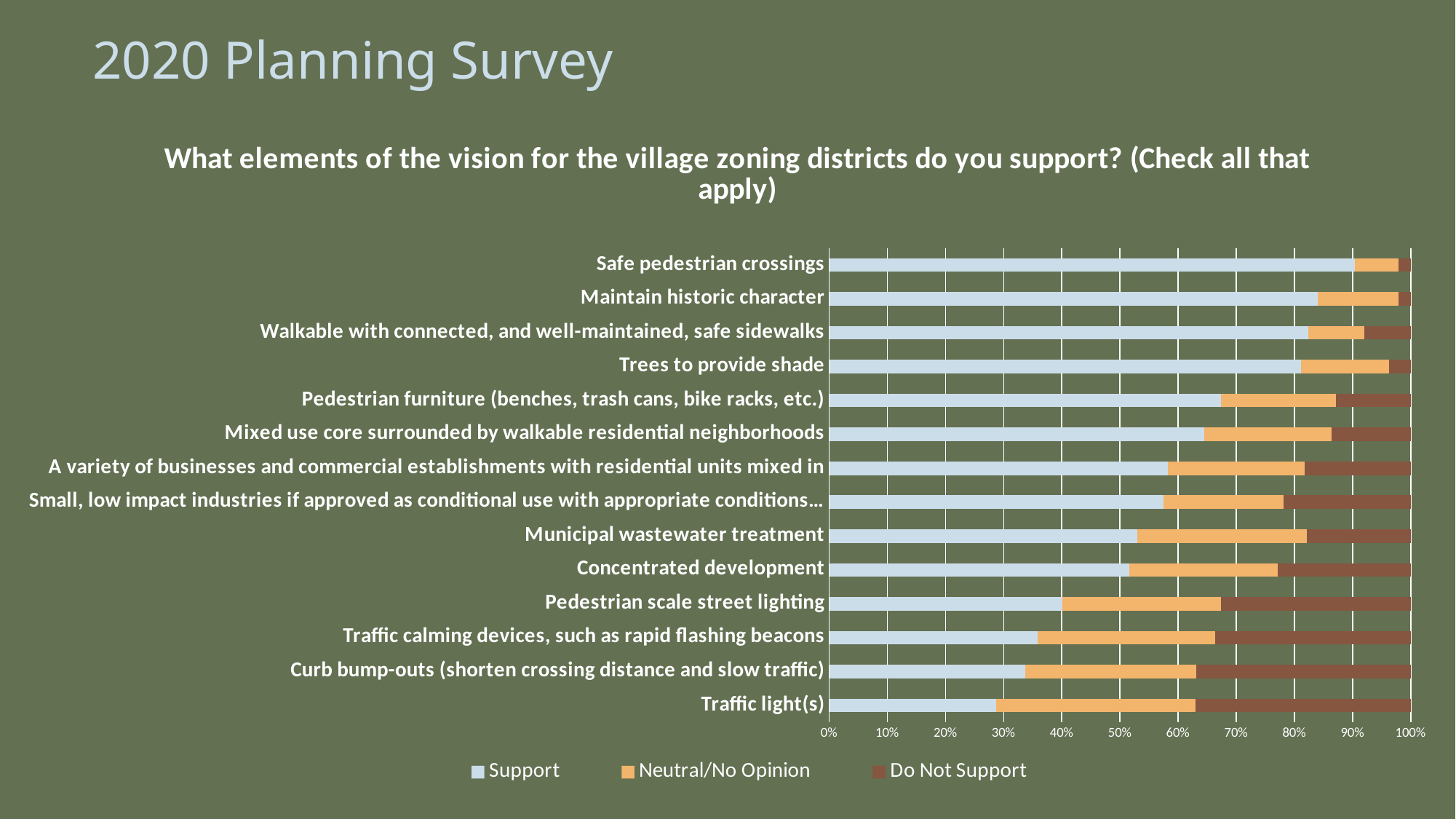
What does each stacked bar in the chart total on the x axis? 100% Which vision element has the highest Support share? Safe pedestrian crossings Which vision element has the lowest Support share? Traffic light(s) How many categories (vision elements) are plotted in the chart? 14 Is the Support value for Trees to provide shade greater or less than 70%? greater Which has a larger Support share: Pedestrian furniture (benches, trash cans, bike racks, etc.) or Traffic calming devices, such as rapid flashing beacons? Pedestrian furniture (benches, trash cans, bike racks, etc.) Which legend entry is shown in light blue? Support How many series does the legend list? 3 Is the Support value for Traffic light(s) greater or less than 40%? less Is the Support value for Curb bump-outs (shorten crossing distance and slow traffic) greater or less than 50%? less What kind of chart is shown on the slide? Stacked bar chart